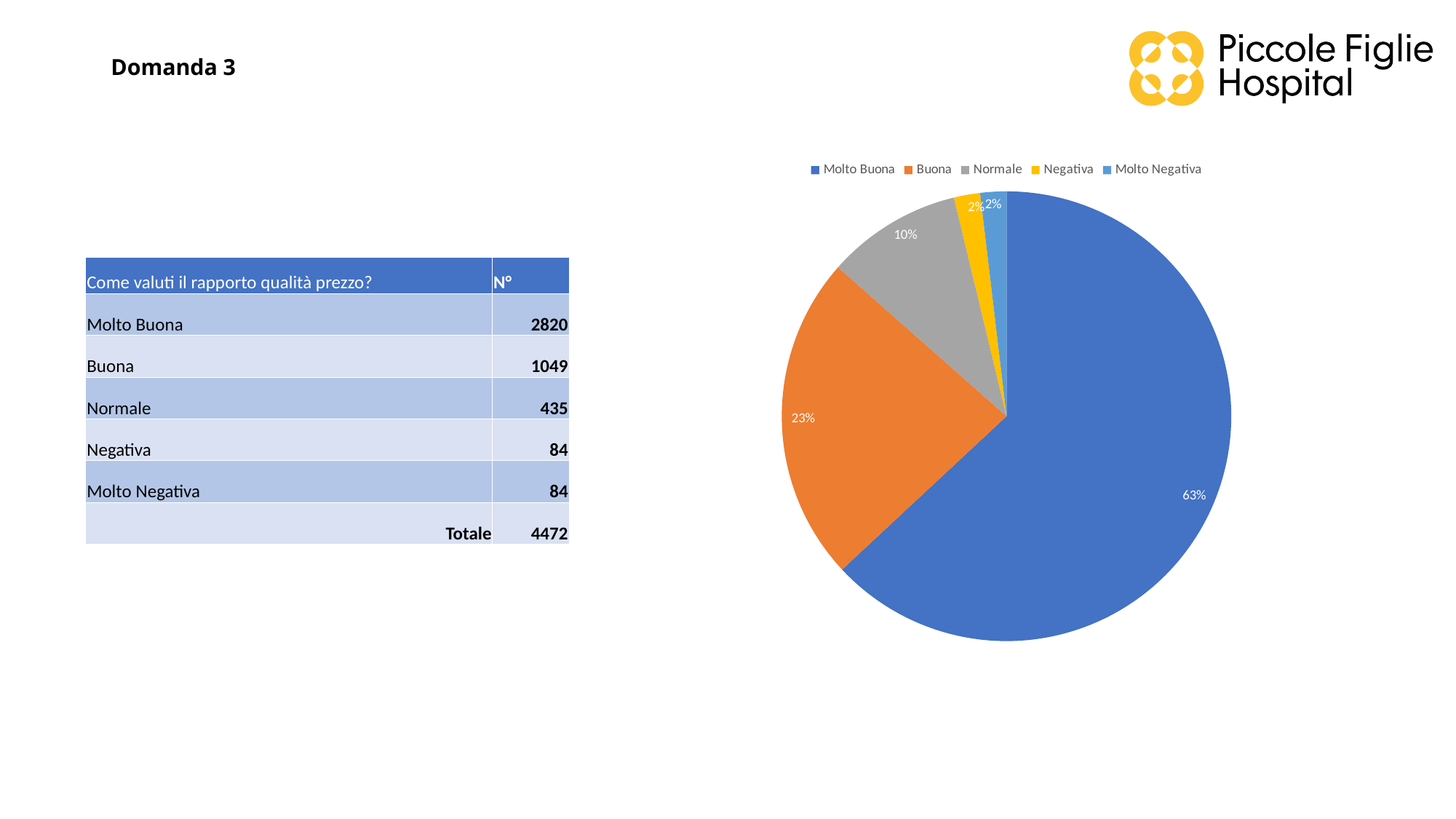
What share of the pie does Molto Buona represent? 63% Which category has the largest slice of the pie? Molto Buona What share of the pie does Negativa represent? 2% What colour is the Normale slice? grey Which slice is larger, Buona or Normale? Buona What is the difference in percentage points between the Molto Buona and Buona slices? 40 What kind of chart is shown on the slide? pie chart How many entries does the legend list? 5 What share of the pie does Normale represent? 10% Which legend entry is shown in orange? Buona How many categories does the pie chart show? 5